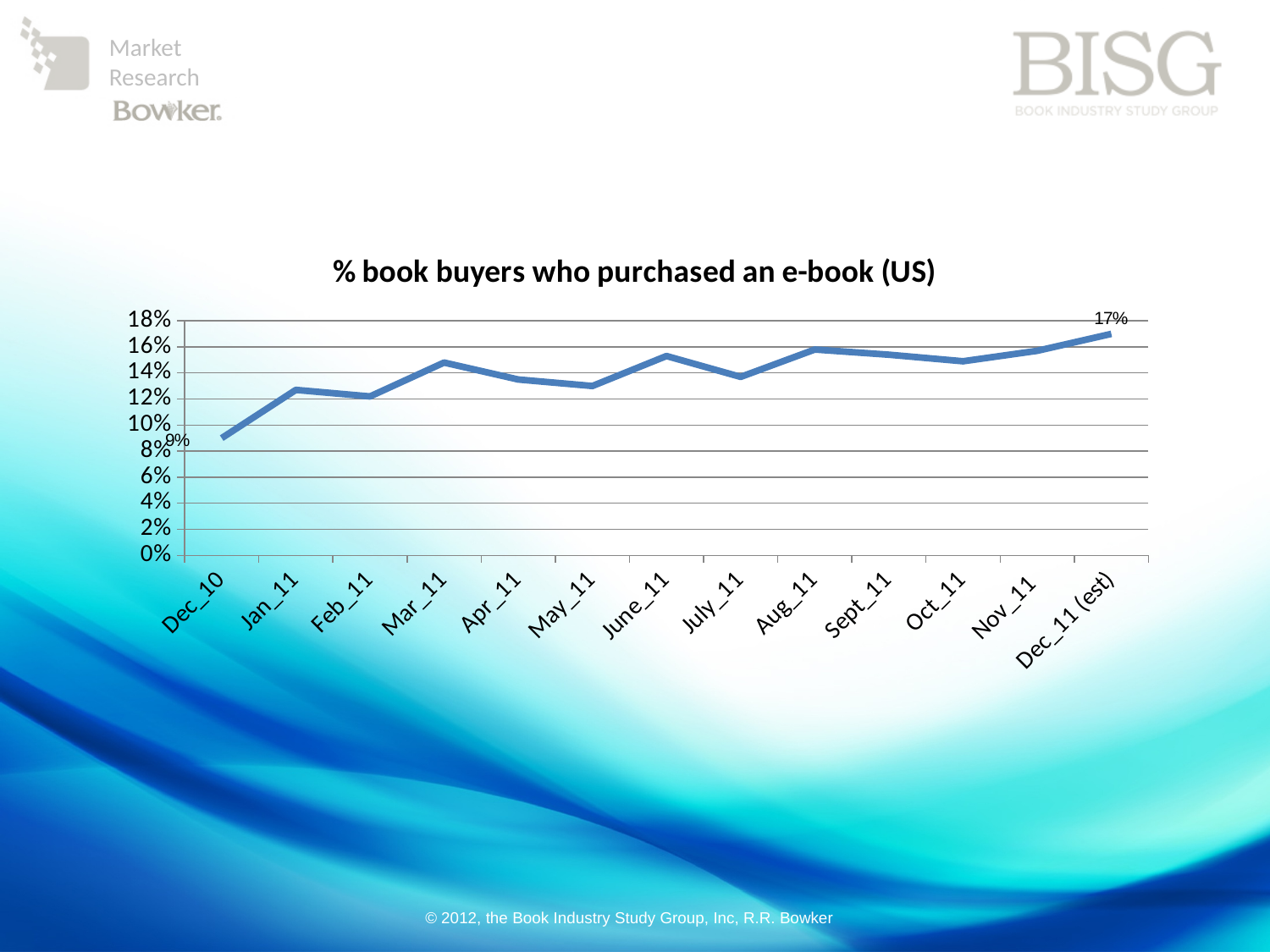
Overall, do the values rise or fall from Dec_10 to Dec_11 (est)? rise Is the value for Aug_11 greater or less than 14%? greater What is the value for Dec_11 (est)? 17% Is the value for May_11 greater or less than 14%? less Which month has the highest value? Dec_11 (est) What is the title of the chart? % book buyers who purchased an e-book (US) How many months are plotted on the x axis? 13 What is the value for Dec_10? 9% Which month has the lowest value? Dec_10 What kind of chart is shown on the slide? line chart Is the value for Jan_11 greater or less than 10%? greater What is the difference between the values for Dec_11 (est) and Dec_10? 8 percentage points